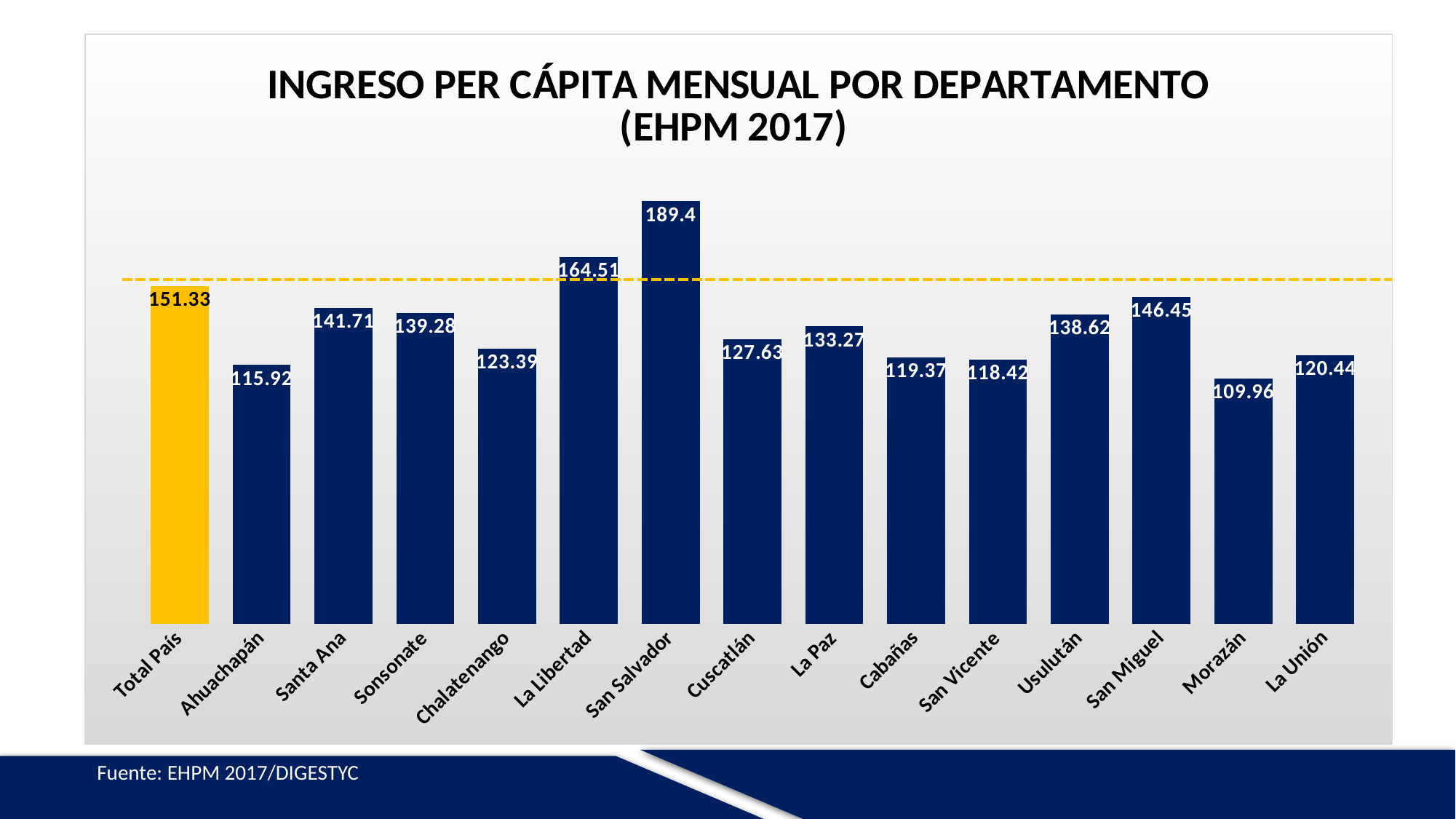
Which is larger, the value for San Miguel or the value for Santa Ana? San Miguel Which bar is coloured yellow instead of dark blue? Total País What is the value for San Salvador? 189.4 What is the difference between the values for San Salvador and Morazán? 79.44 What kind of chart is shown on the slide? Bar chart What is the value for Morazán? 109.96 What is the value for Usulután? 138.62 What is the value for Total País? 151.33 Which department has the lowest monthly per capita income? Morazán What is the difference between the values for La Libertad and Total País? 13.18 How many bars are shown in the chart? 15 Which department has the highest monthly per capita income? San Salvador